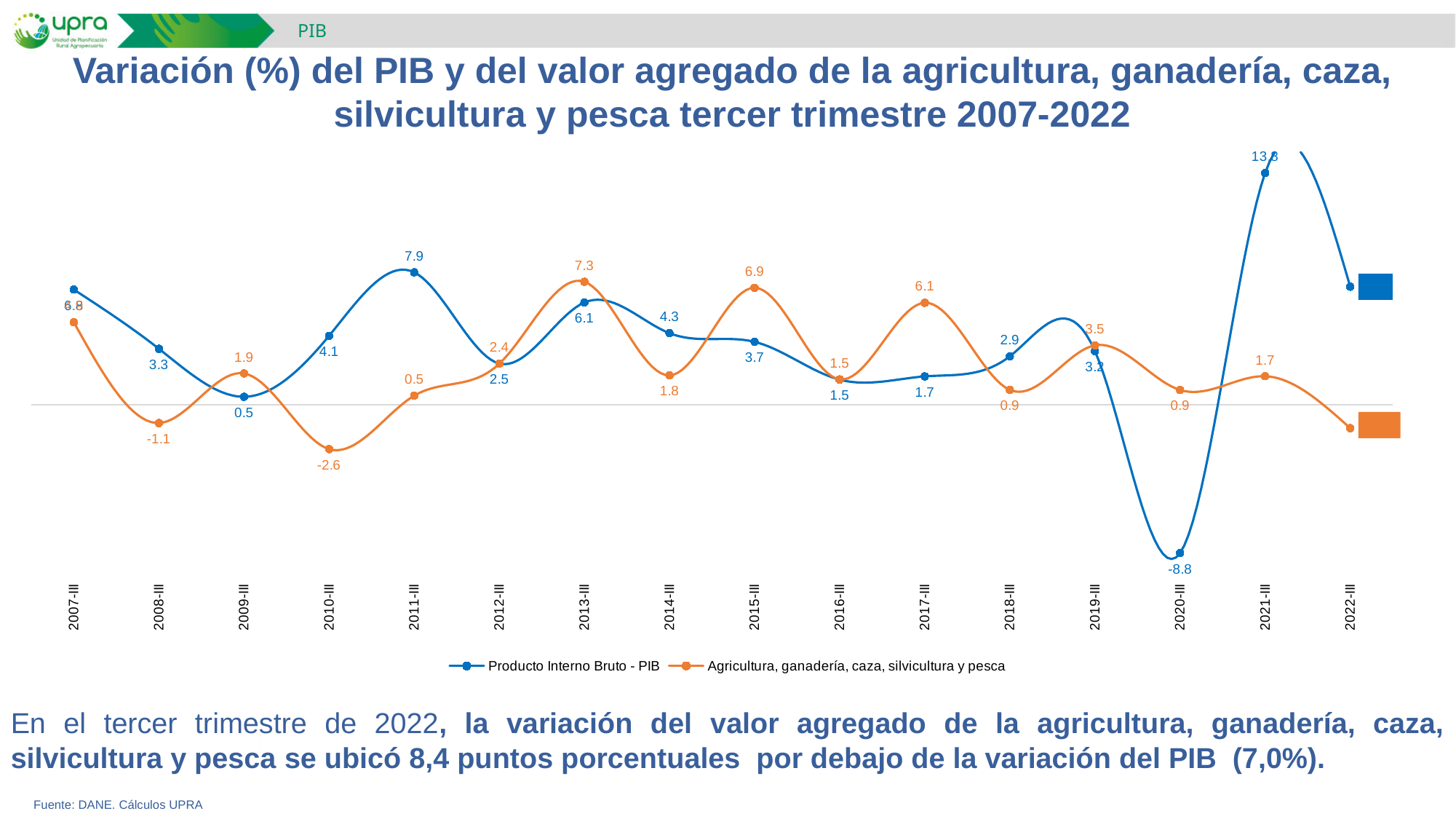
In which period is the Agricultura, ganadería, caza, silvicultura y pesca value highest? 2013-III How many series does the legend list? 2 What is the difference between the Agricultura, ganadería, caza, silvicultura y pesca value and the Producto Interno Bruto - PIB value in 2017-III? 4.4 What is the value of Agricultura, ganadería, caza, silvicultura y pesca for 2010-III? -2.6 In which period is the Producto Interno Bruto - PIB value highest? 2021-III What is the value of Producto Interno Bruto - PIB for 2020-III? -8.8 What is the value of Producto Interno Bruto - PIB for 2011-III? 7.9 How many periods are shown on the x axis? 16 In 2015-III, which series has the larger value: Producto Interno Bruto - PIB or Agricultura, ganadería, caza, silvicultura y pesca? Agricultura, ganadería, caza, silvicultura y pesca In which period is the Producto Interno Bruto - PIB value lowest? 2020-III What is the value of Agricultura, ganadería, caza, silvicultura y pesca for 2013-III? 7.3 What kind of chart is shown on the slide? line chart